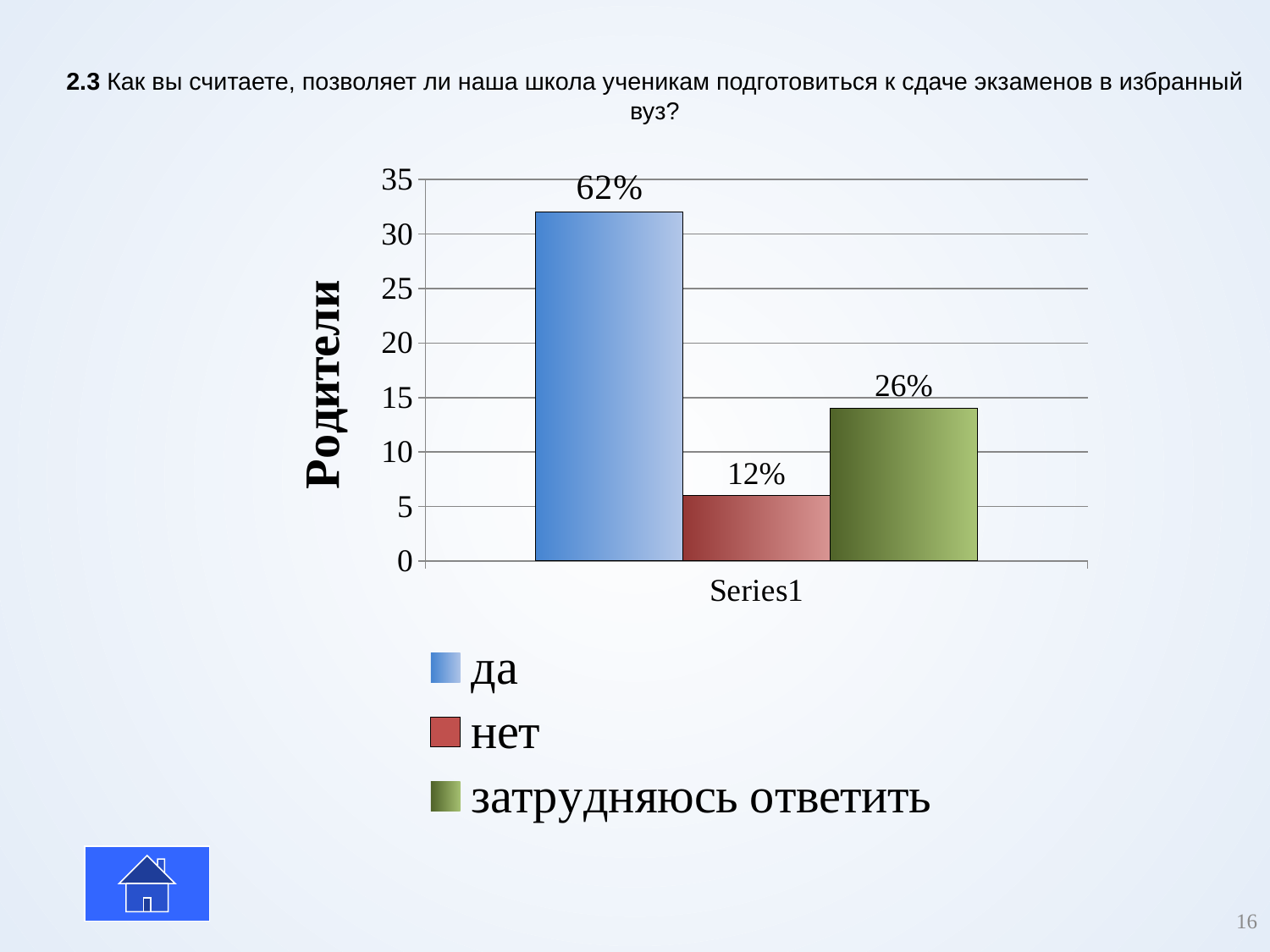
What kind of chart is shown on the slide? bar chart Is the bar for "нет" greater or less than 10 on the vertical axis? less What data label is shown on the bar for "да"? 62% Is the bar for "да" greater or less than 30 on the vertical axis? greater What is the difference between the data labels for "да" and "нет"? 50% Which response has the shortest bar? нет Which bar is taller: "нет" or "затрудняюсь ответить"? затрудняюсь ответить What data label is shown on the bar for "нет"? 12% How many bars are plotted in the chart? 3 How many entries does the legend list? 3 What data label is shown on the bar for "затрудняюсь ответить"? 26% Which response has the tallest bar? да